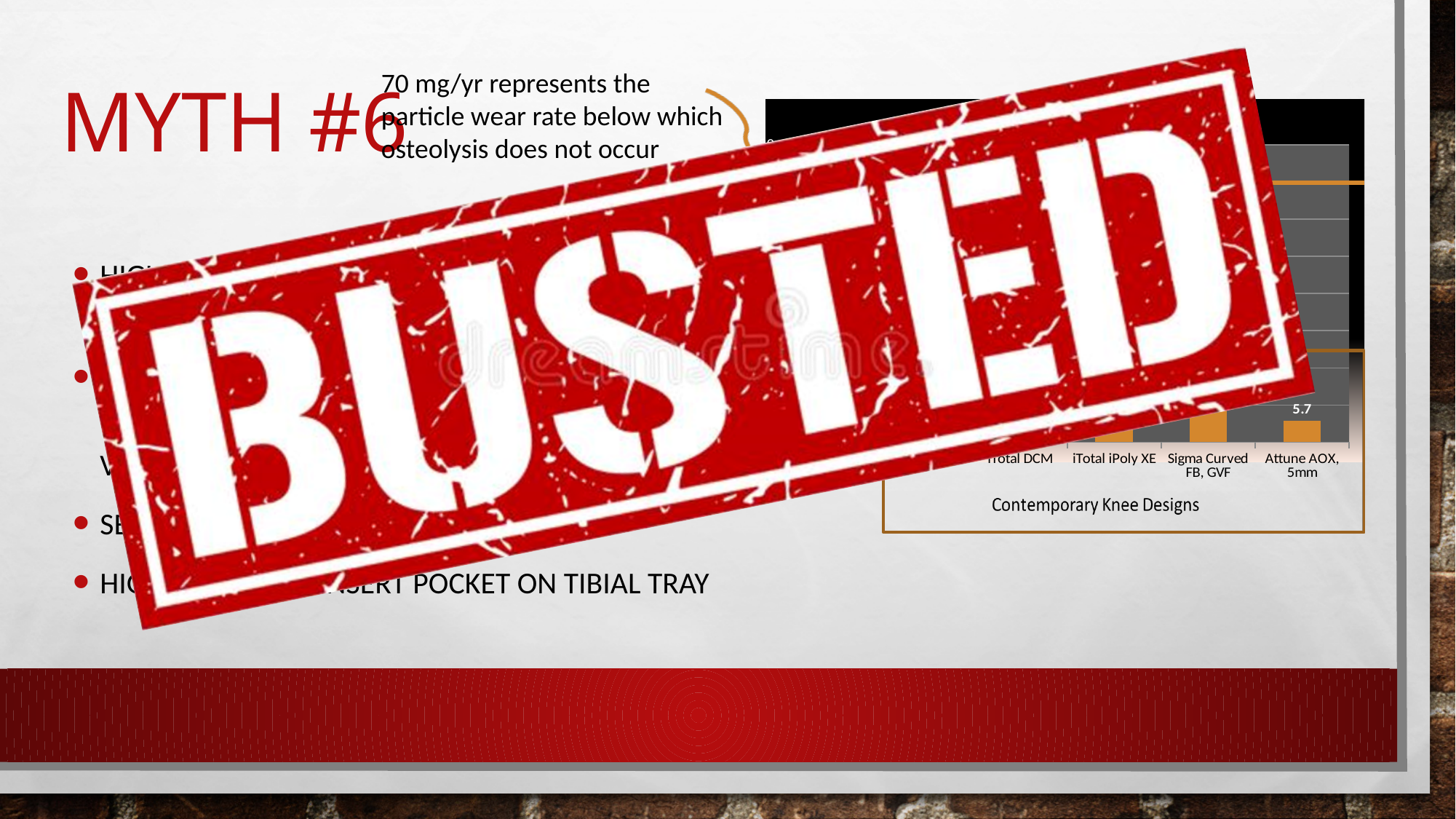
What is the x-axis title of the chart? Contemporary Knee Designs What is the value shown for Attune AOX, 5mm in the chart? 5.7 What colour are the bars in the chart? orange What kind of chart is shown on the slide? bar chart